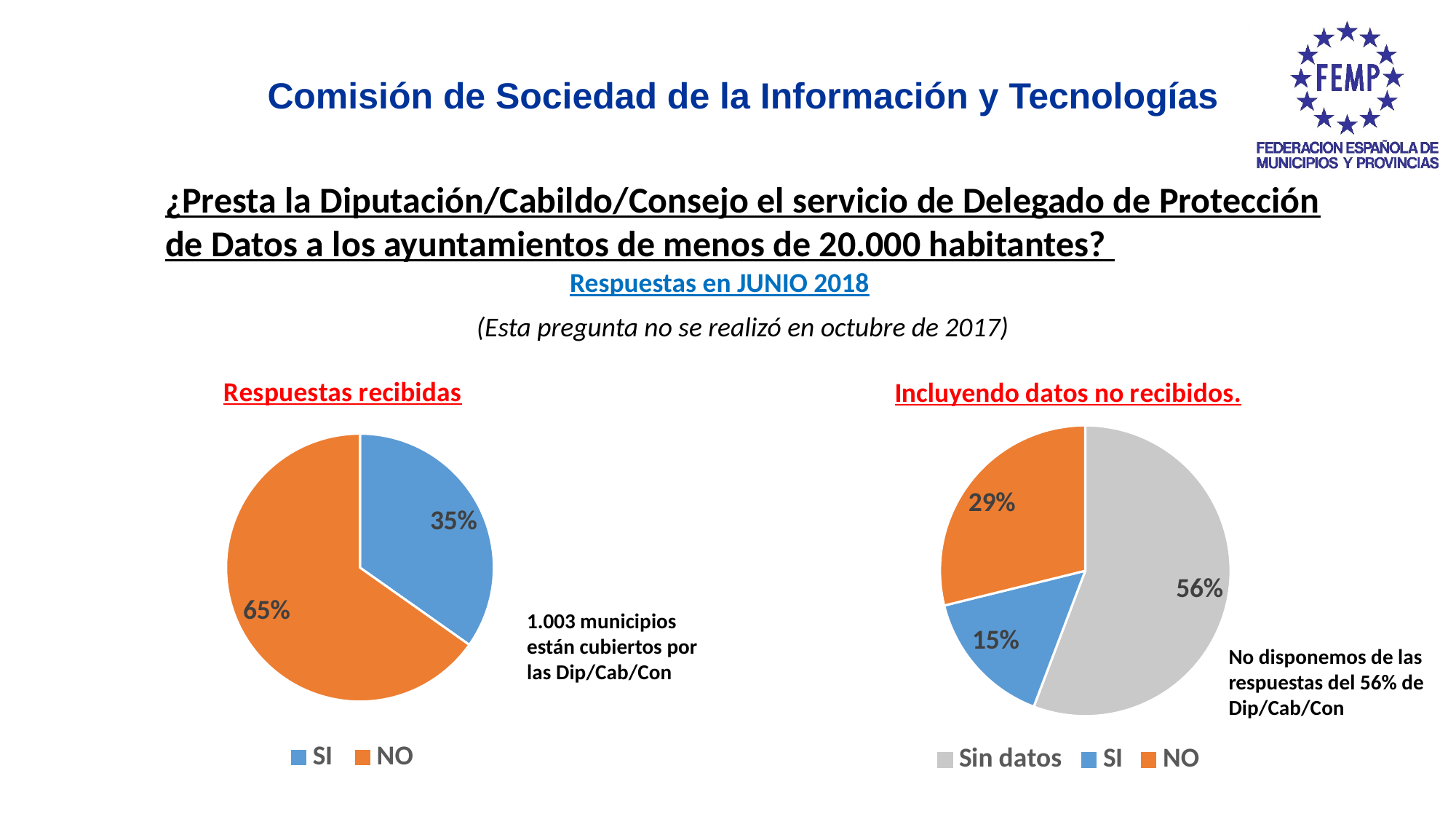
In the 'Respuestas recibidas' pie chart, what share is labelled for SI? 35% How many categories does the legend of the 'Incluyendo datos no recibidos.' pie chart list? 3 In the 'Incluyendo datos no recibidos.' pie chart, which category has the smallest slice? SI In the 'Incluyendo datos no recibidos.' pie chart, which is larger, NO or SI? NO In the 'Respuestas recibidas' pie chart, what is the difference in percentage points between NO and SI? 30 What kind of chart is the 'Respuestas recibidas' chart? Pie chart In the 'Respuestas recibidas' pie chart, what share is labelled for NO? 65% In the 'Incluyendo datos no recibidos.' pie chart, what share is labelled for Sin datos? 56% In the 'Incluyendo datos no recibidos.' pie chart, what colour is the Sin datos slice? Grey In the 'Incluyendo datos no recibidos.' pie chart, what share is labelled for SI? 15% In the 'Incluyendo datos no recibidos.' pie chart, what share is labelled for NO? 29% In the 'Respuestas recibidas' pie chart, which category has the largest slice? NO